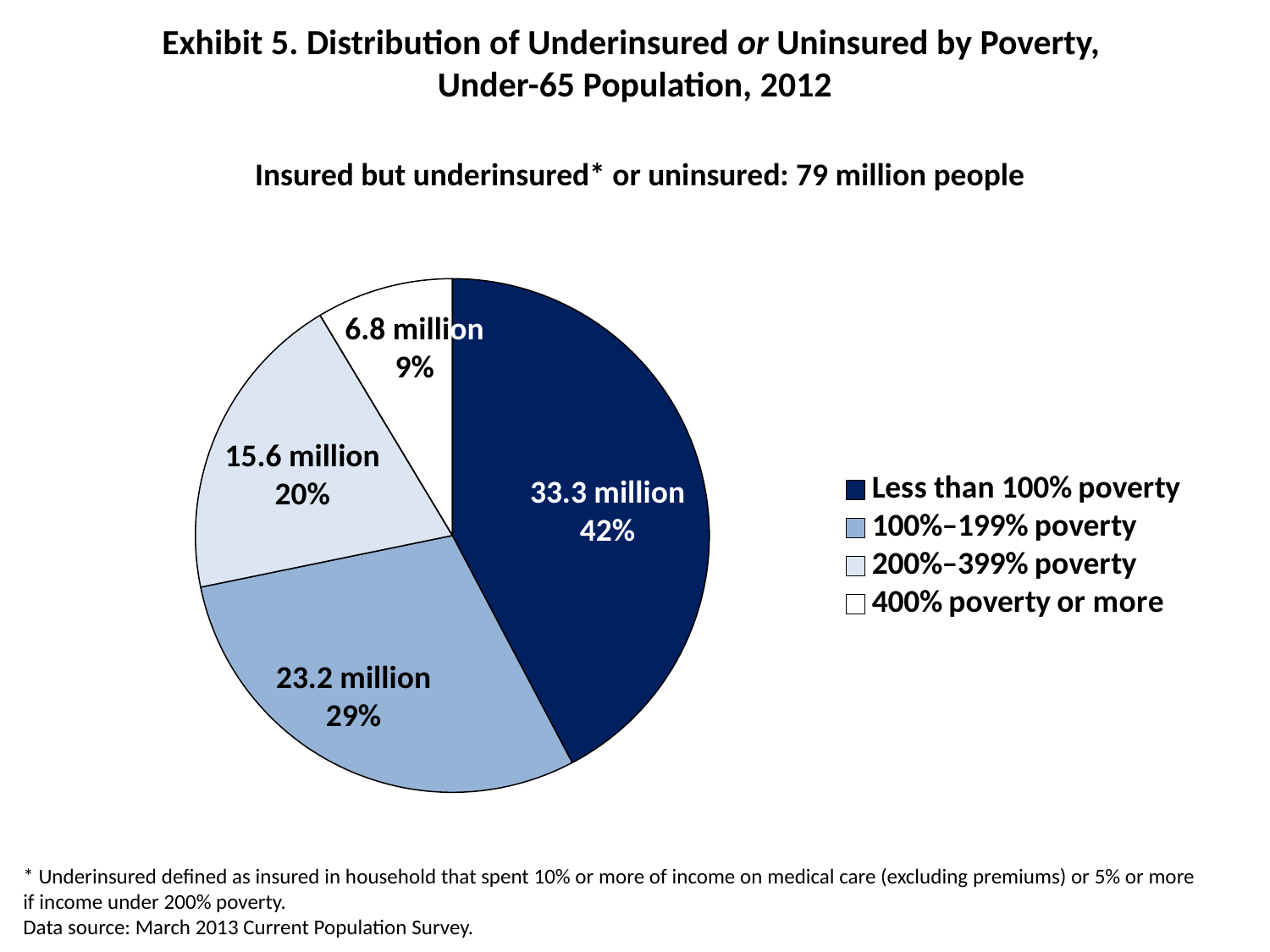
How many slices does the pie chart have? 4 Which slice is larger: '200%–399% poverty' or '400% poverty or more'? 200%–399% poverty Which poverty group has the largest slice? Less than 100% poverty What share of the pie is the '400% poverty or more' slice? 9% What is the difference in millions between the 'Less than 100% poverty' and '100%–199% poverty' slices? 10.1 million Which poverty group has the smallest slice? 400% poverty or more What share of the pie is the '100%–199% poverty' slice? 29% How many people are in the 'Less than 100% poverty' slice? 33.3 million How many people are in the '200%–399% poverty' slice? 15.6 million How many entries does the legend list? 4 What kind of chart is shown on the slide? Pie chart According to the subtitle, how many people are insured but underinsured or uninsured in total? 79 million people